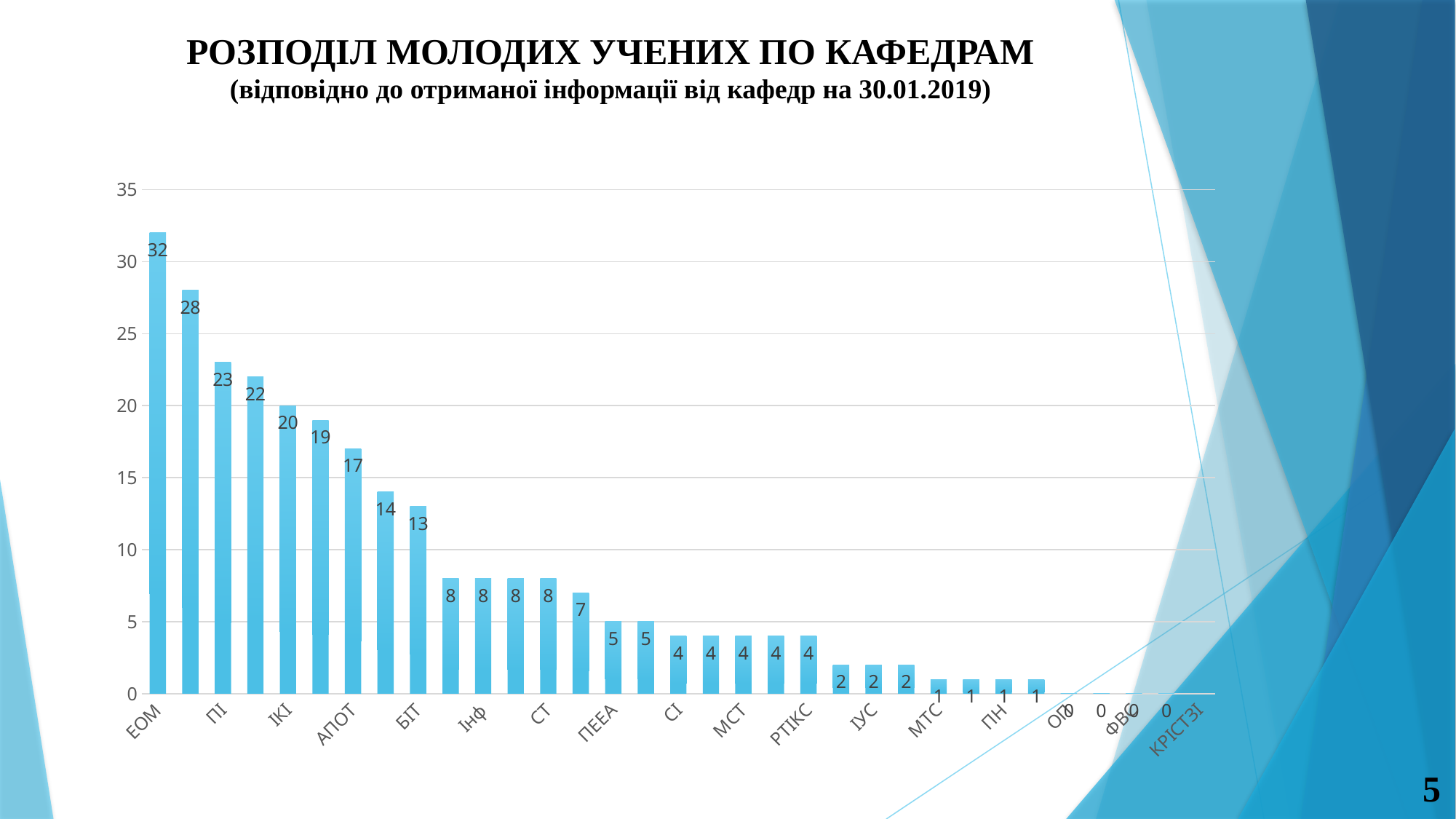
What value is shown for the ПІ department? 23 What value is shown for the ІКІ department? 20 What is the difference between the values for ЕОМ and ПІ? 9 Which department has the highest number of young scientists? ЕОМ What value is shown for the БІТ department? 13 Is the value for ЕОМ greater or less than 30? greater What is the main title of the chart on the slide? РОЗПОДІЛ МОЛОДИХ УЧЕНИХ ПО КАФЕДРАМ How many young scientists does the chart show for the ЕОМ department? 32 Which has a larger value, ІКІ or АПОТ? ІКІ Do the values rise or fall from left to right along the x axis? fall What value is shown for the АПОТ department? 17 What kind of chart is shown on the slide? bar chart